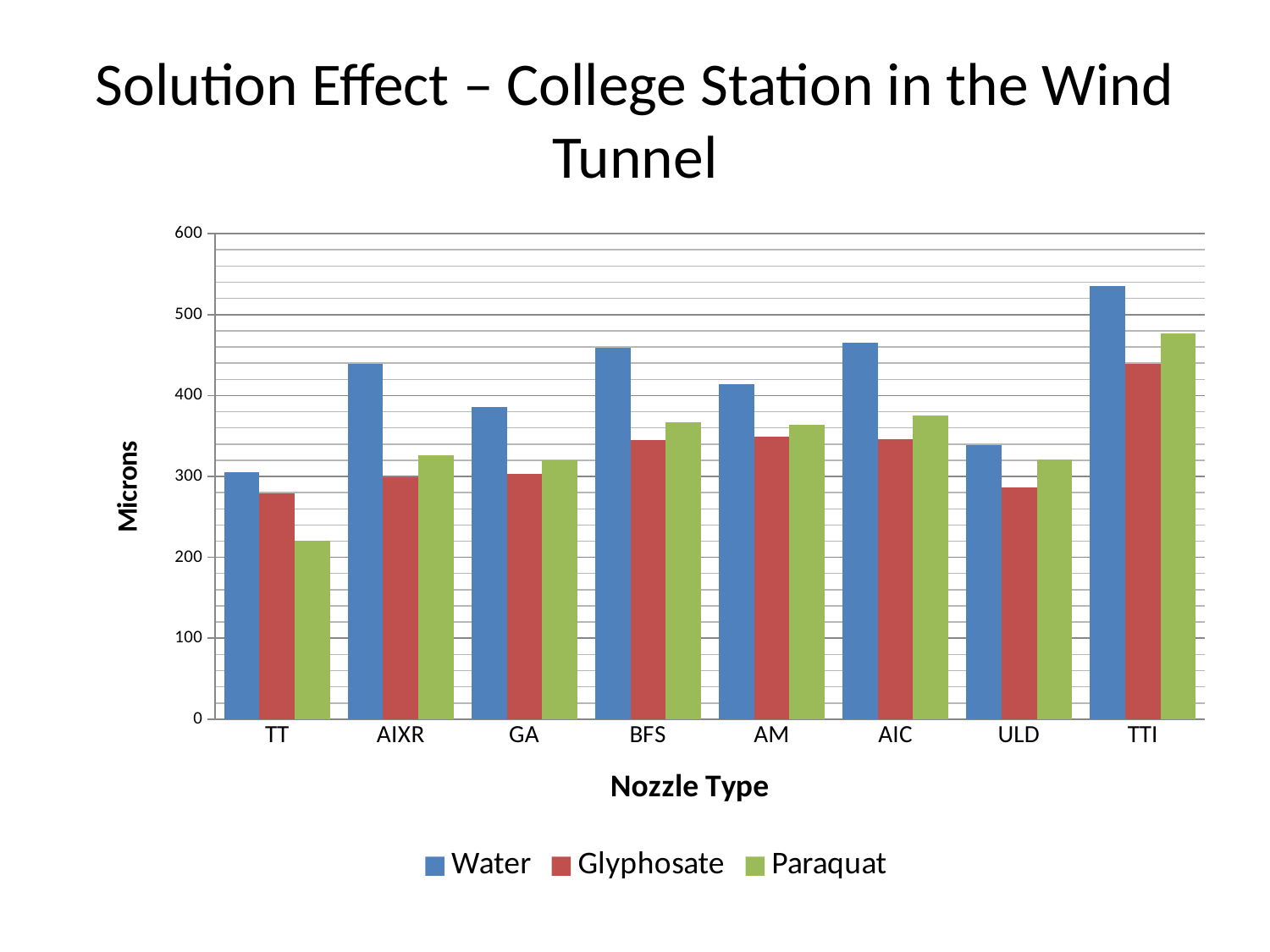
Which nozzle type has the lowest Water value? TT Is the Paraquat value for TT greater or less than 300? less How many nozzle types are shown on the x axis? 8 Which is larger, the Water value for AIC or the Water value for AM? AIC What kind of chart is shown on the slide? bar chart Which nozzle type has the lowest Paraquat value? TT Is the Water value for TTI greater or less than 500? greater Which nozzle type has the highest Water value? TTI How many series does the legend list? 3 Is the Water value for AIXR greater or less than 400? greater Which nozzle type has the highest Glyphosate value? TTI What is the label of the y axis? Microns